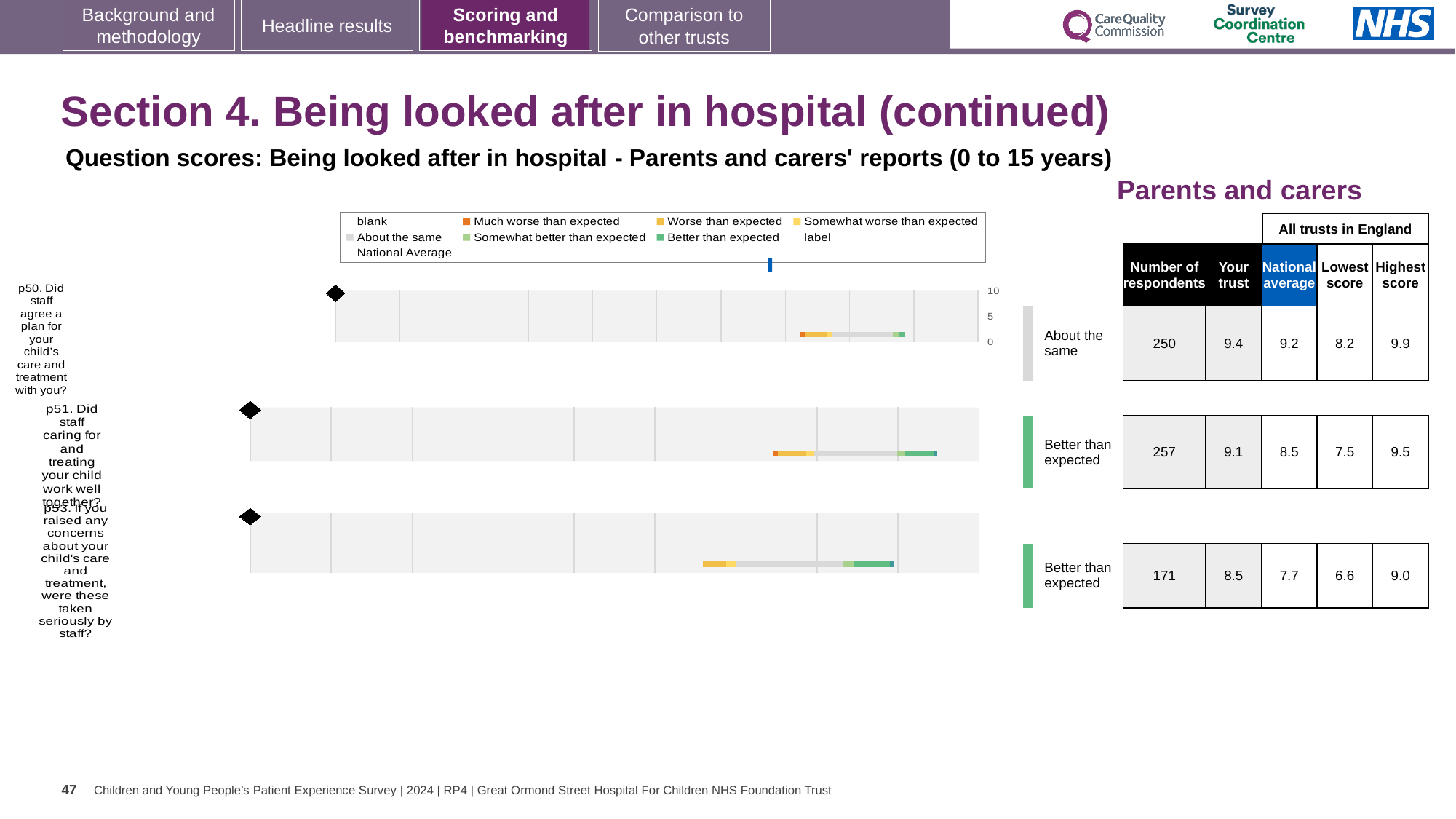
What is the highest score among all trusts in England for p53? 9.0 Which question has the lowest national average score? p53 How many questions are plotted on the slide? 3 Which has the larger 'Your trust' score, p51 or p53? p51 How many respondents answered p53 (If you raised any concerns about your child's care and treatment, were these taken seriously by staff)? 171 What is the difference between the highest score and the lowest score for p53? 2.4 What kind of chart is used to show the question scores? Bar chart By how much does the 'Your trust' score for p50 exceed the national average for p50? 0.2 What benchmark category is shown for p50? About the same Which question has the highest 'Your trust' score? p50 What is the 'Your trust' score for p50 (Did staff agree a plan for your child's care and treatment with you)? 9.4 What is the national average score for p51 (Did staff caring for and treating your child work well together)? 8.5